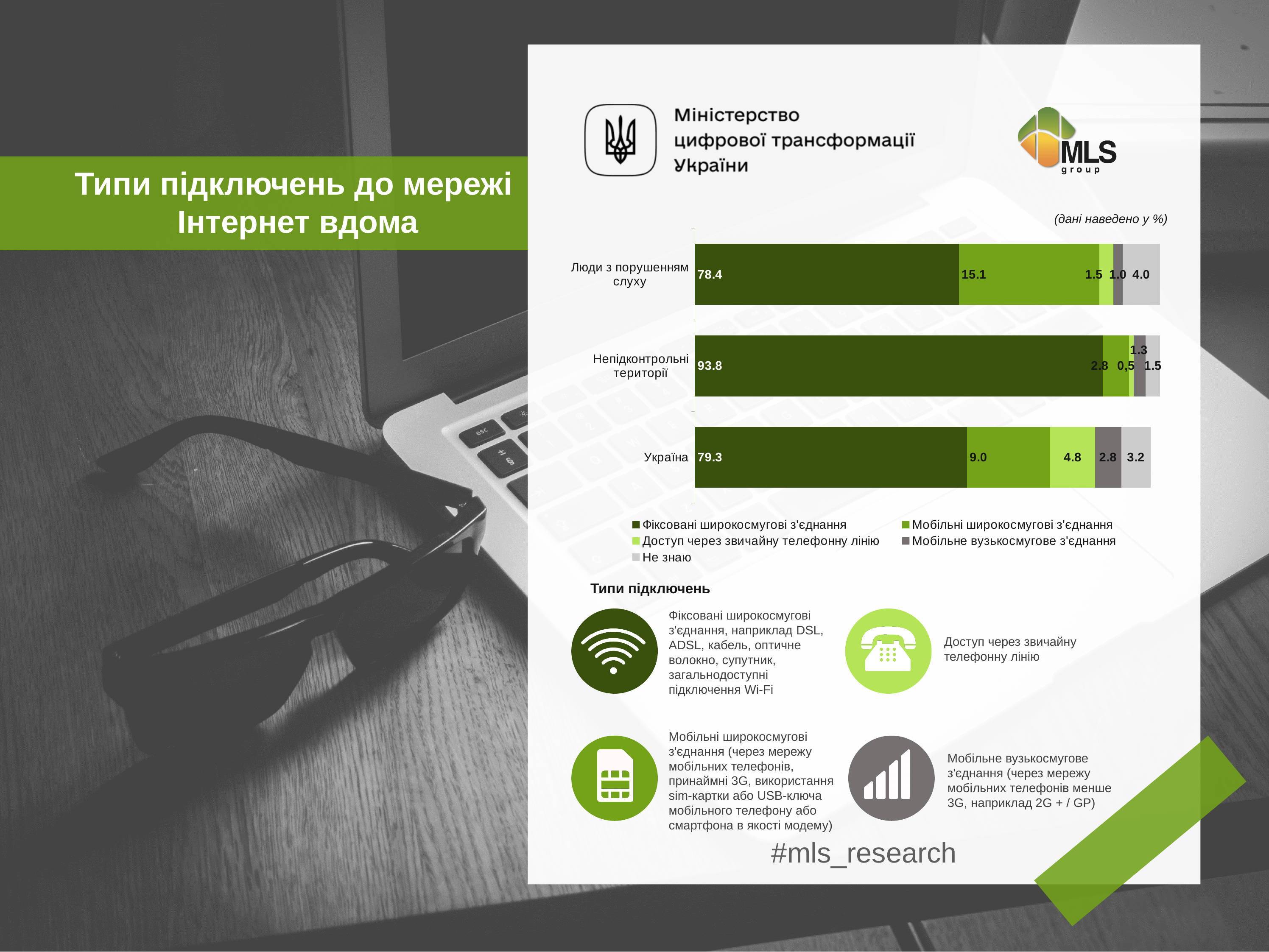
What is the total of the stacked bar for 'Люди з порушенням слуху'? 100.0 How many series does the chart legend list? 5 How many categories (groups) are shown on the chart? 3 What is the difference between the 'Фіксовані широкосмугові з'єднання' values for 'Непідконтрольні території' and 'Люди з порушенням слуху'? 15.4 What type of chart is shown on the slide? Stacked bar chart Which category has the highest value for 'Фіксовані широкосмугові з'єднання'? Непідконтрольні території What is the value of 'Не знаю' for 'Україна'? 3.2 What is the value of 'Фіксовані широкосмугові з'єднання' for 'Непідконтрольні території'? 93.8 Which category has the lowest value for 'Мобільні широкосмугові з'єднання'? Непідконтрольні території Which is larger: the 'Доступ через звичайну телефонну лінію' value for 'Україна' or for 'Люди з порушенням слуху'? Україна What is the value of 'Фіксовані широкосмугові з'єднання' for 'Україна'? 79.3 What is the value of 'Мобільні широкосмугові з'єднання' for 'Люди з порушенням слуху'? 15.1